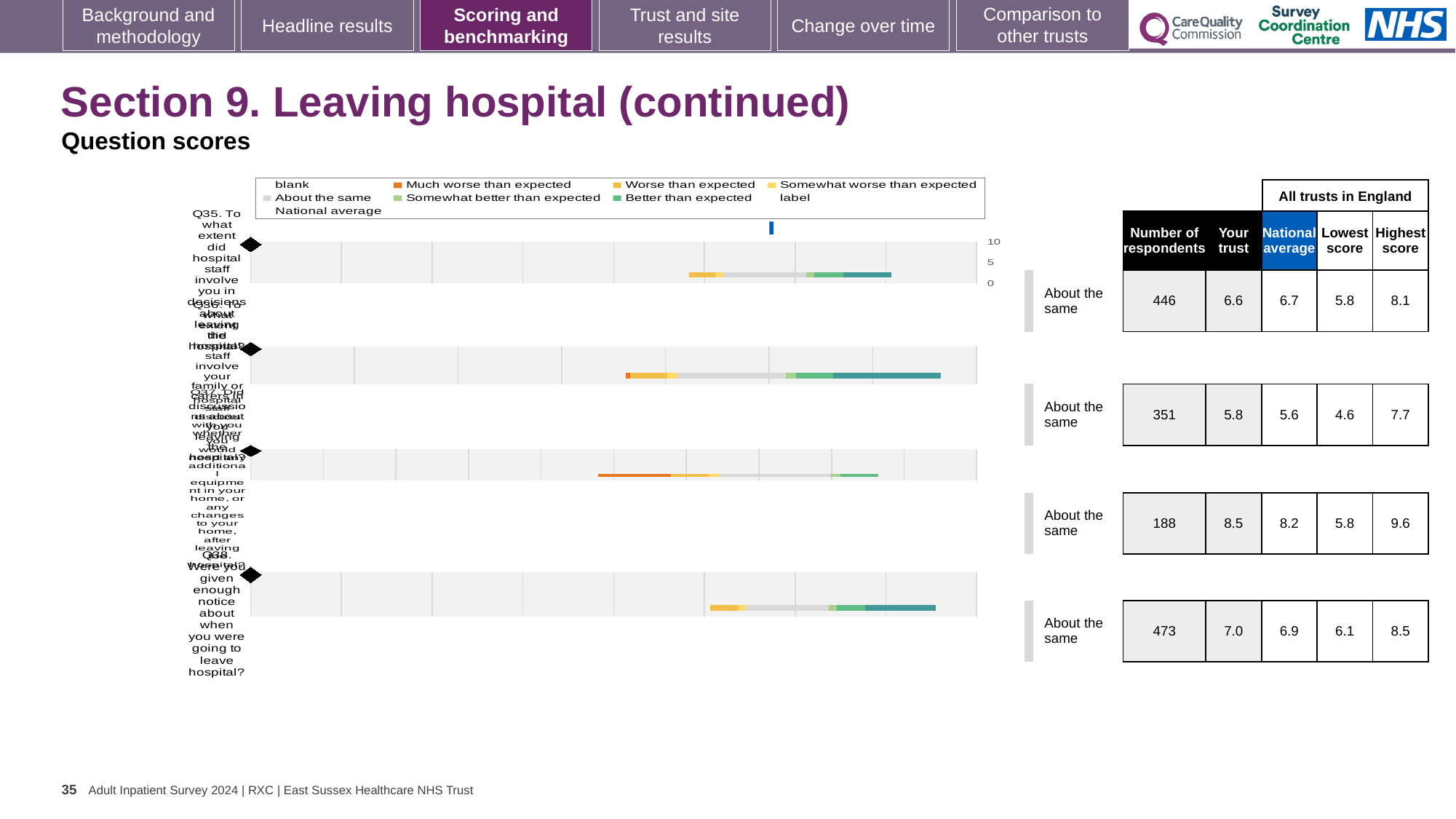
What is the national average for Q38 (the last row of the table)? 6.9 What type of chart is used to show the question scores on this slide? bar chart For Q38 (the last row), which is larger: the 'Your trust' score or the national average? Your trust How many questions (bars) are plotted in the chart? 4 In the table, what is the number of respondents for Q35 (the first row)? 446 Which row of the table has the lowest 'Your trust' score? the second row (5.8) For Q38 (the last row), how much higher is the 'Your trust' score than the national average? 0.1 Which row of the table has the highest 'Your trust' score? the third row (8.5) What benchmark category label is shown next to each of the four bars? About the same What is the highest score among all trusts in England for the third row of the table? 9.6 What is the 'Your trust' score for Q35 (the first row of the table)? 6.6 For Q35 (the first row), what is the difference between the highest score and the lowest score across all trusts in England? 2.3